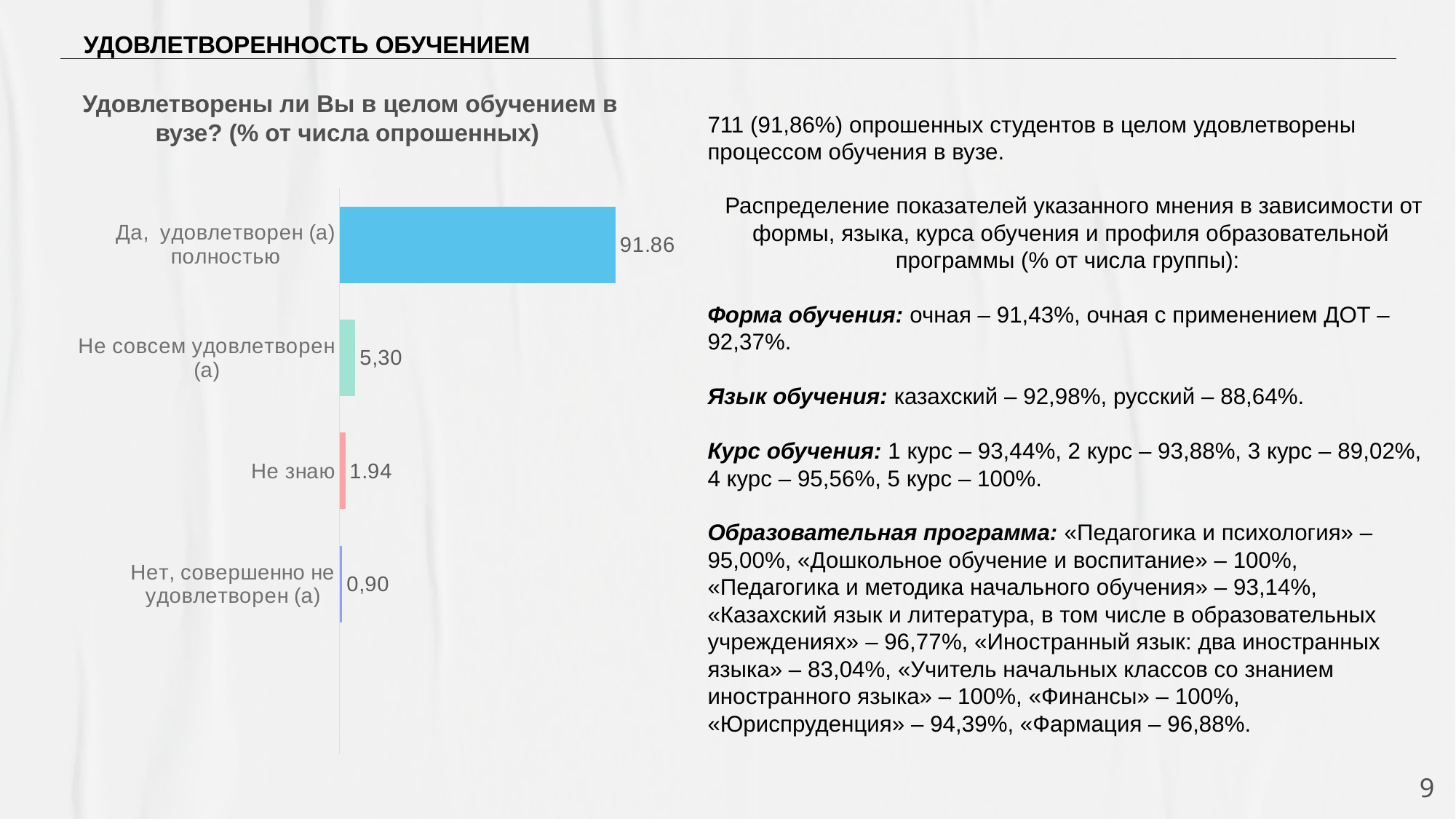
Which category has the highest value? Да, удовлетворен (а) полностью What is the value for "Не знаю"? 1.94 Which is larger: the value for "Не совсем удовлетворен (а)" or the value for "Не знаю"? Не совсем удовлетворен (а) What is the value for "Да, удовлетворен (а) полностью"? 91.86 What is the value for "Нет, совершенно не удовлетворен (а)"? 0,90 What is the title of the chart? Удовлетворены ли Вы в целом обучением в вузе? (% от числа опрошенных) What type of chart is shown on the slide? bar chart What colour is the bar for "Да, удовлетворен (а) полностью"? blue What is the difference between the value for "Да, удовлетворен (а) полностью" and the value for "Не знаю"? 89.92 What is the value for "Не совсем удовлетворен (а)"? 5,30 Which category has the lowest value? Нет, совершенно не удовлетворен (а) How many categories are shown in the chart? 4